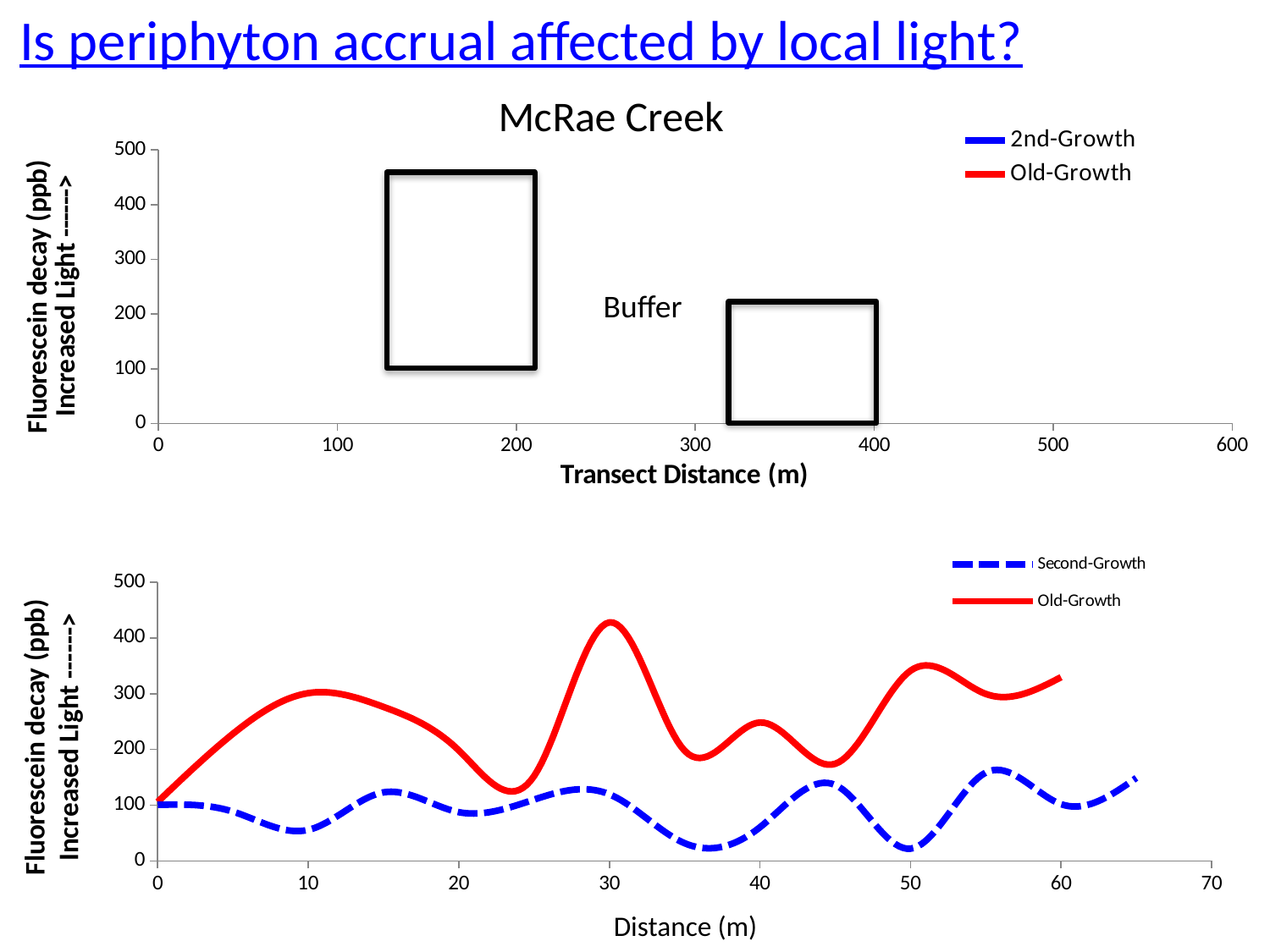
What is the x-axis title of the bottom chart? Distance (m) In the bottom chart, which series has the higher value at 30 m, Second-Growth or Old-Growth? Old-Growth How many series does the legend of the bottom chart list? 2 In the bottom chart, is the Old-Growth value at 30 m greater or less than 400? greater In the bottom chart, does the Old-Growth line rise or fall between 0 m and 10 m? rise In the bottom chart, which series reaches the highest value on the chart? Old-Growth In the bottom chart, is the Second-Growth value at 50 m greater or less than 100? less In the bottom chart, is the Second-Growth value at 60 m greater or less than 200? less What is the title of the top chart? McRae Creek What type of chart is the bottom chart on the slide? line chart How many series does the legend of the top chart (McRae Creek) list? 2